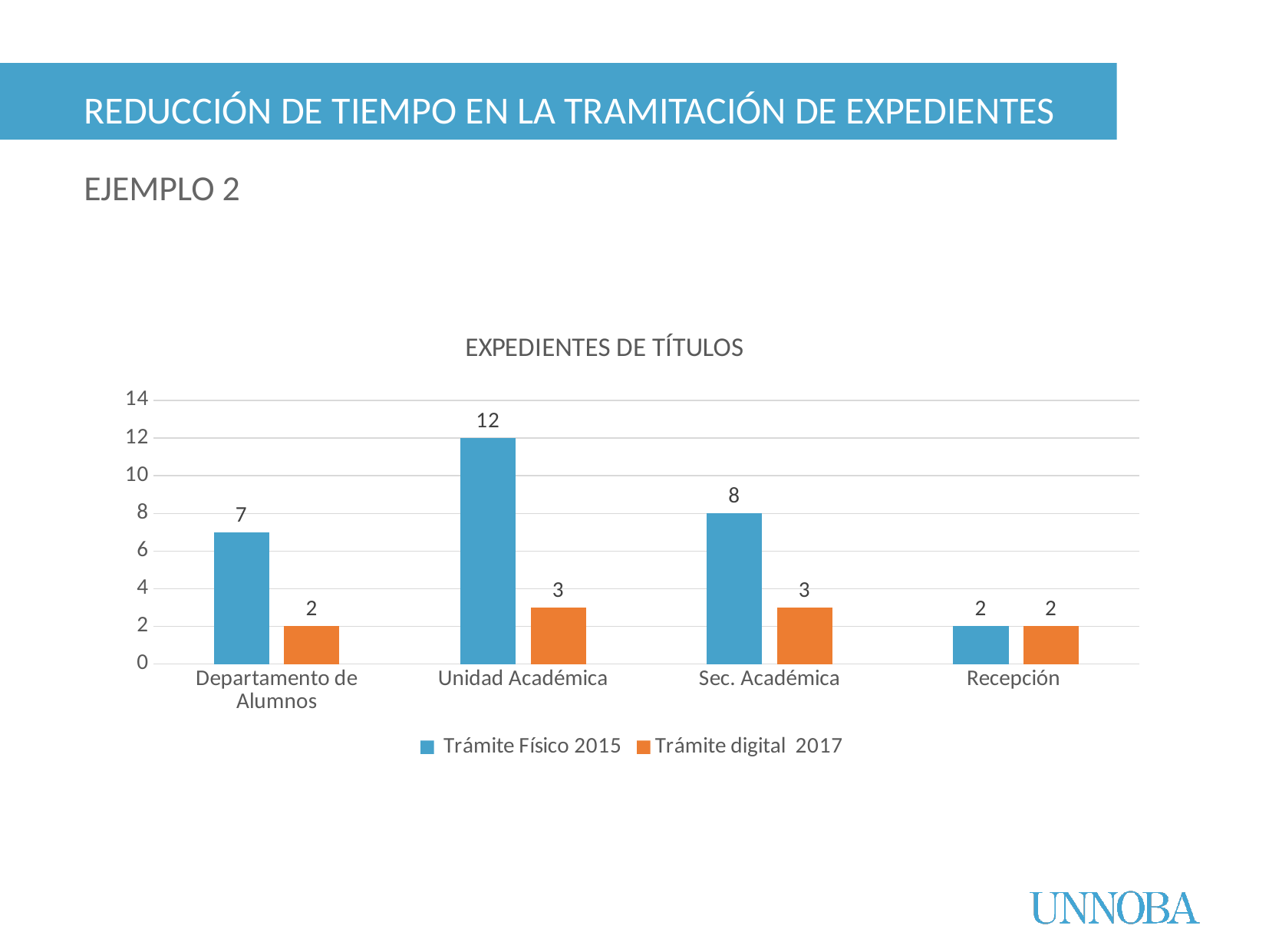
Which category has the lowest value for Trámite Físico 2015? Recepción What kind of chart is shown on the slide? Bar chart What is the difference between Trámite Físico 2015 and Trámite digital 2017 in Departamento de Alumnos? 5 What is the value for Trámite digital 2017 in Departamento de Alumnos? 2 What is the value for Trámite Físico 2015 in Sec. Académica? 8 What is the value for Trámite Físico 2015 in Unidad Académica? 12 How many categories are shown on the x axis? 4 Which category has the highest value for Trámite Físico 2015? Unidad Académica What is the title of the chart? EXPEDIENTES DE TÍTULOS How many series does the legend list? 2 What is the difference between Trámite Físico 2015 and Trámite digital 2017 in Unidad Académica? 9 Which is larger in Sec. Académica: Trámite Físico 2015 or Trámite digital 2017? Trámite Físico 2015